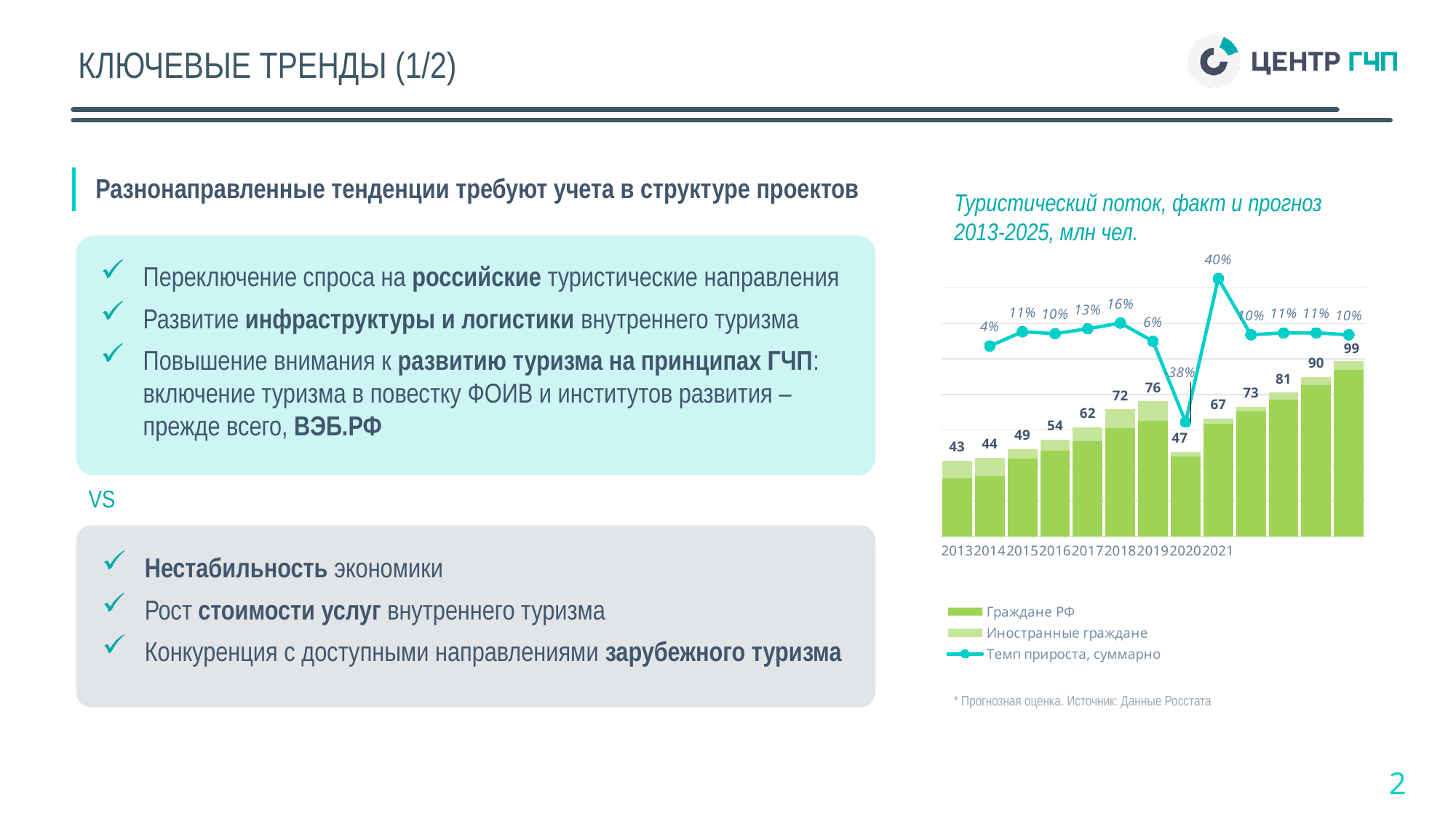
What is the difference between the total values for 2021 and 2020? 20 How many series does the legend list? 3 Which year has the lowest total tourist flow value? 2013 What is the difference between the total values for 2019 and 2020? 29 What kind of chart is used to show the tourist flow? Stacked bar chart with a line What is the total tourist flow value shown for 2020? 47 Which year has the larger total value, 2016 or 2017? 2017 What growth rate (Темп прироста, суммарно) is shown for 2021? 40% Do the total values rise or fall from 2013 to 2019? Rise What is the total tourist flow value shown for 2018? 72 What is the total tourist flow value shown for 2013? 43 What growth rate (Темп прироста, суммарно) is shown for 2014? 4%